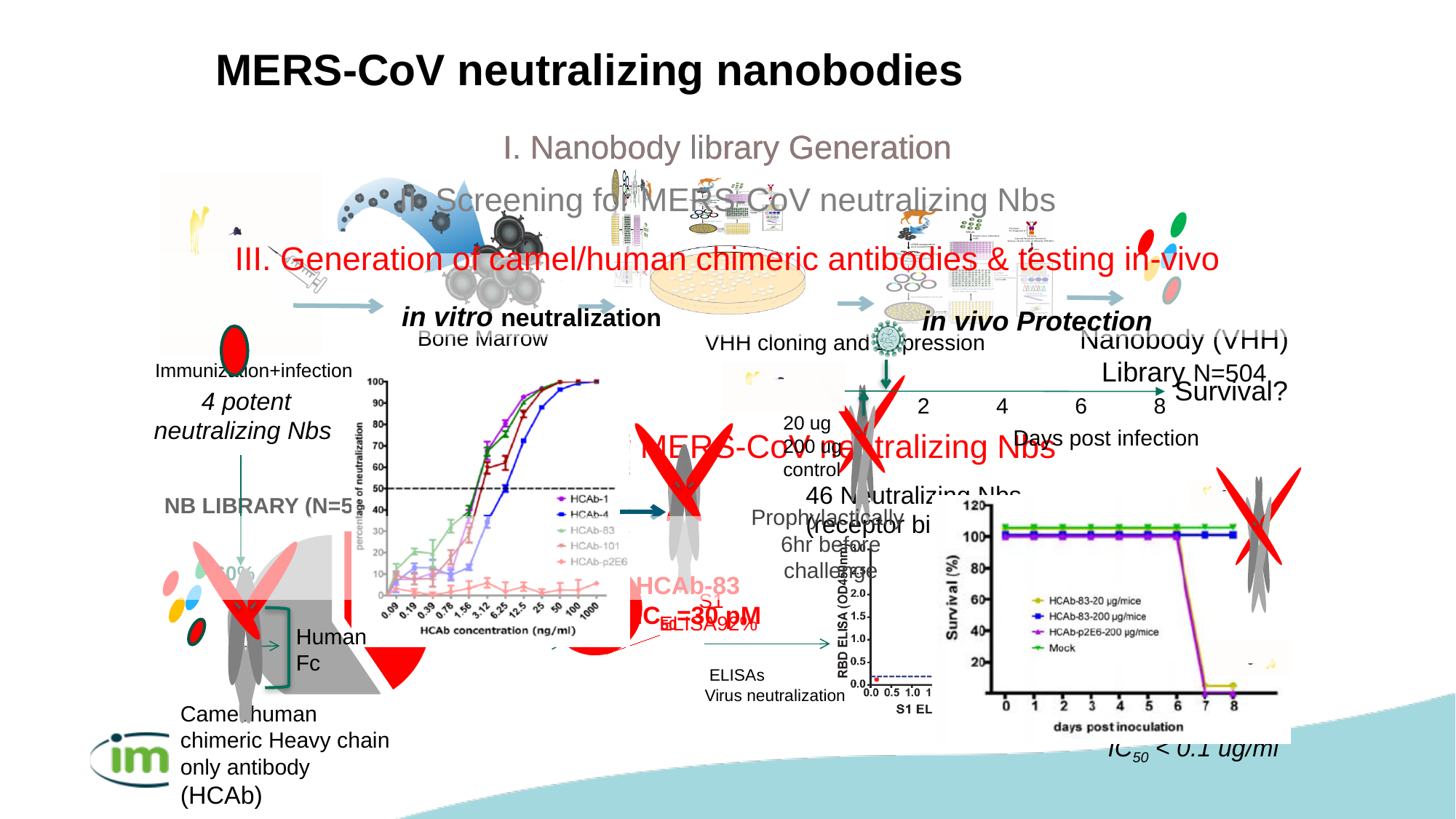
How many series does the legend of the in vitro neutralization chart list? 5 What kind of chart is the in vitro neutralization chart (percentage of neutralization vs HCAb concentration)? line chart In the survival chart, is the value for HCAb-p2E6-200 µg/mice at day 8 greater or less than 20? less In the in vitro neutralization chart, what is the label of the x axis? HCAb concentration (ng/ml) What kind of chart is the survival chart (Survival (%) vs days post inoculation)? line chart How many series does the legend of the survival chart list? 4 In the survival chart, what is the survival percentage for HCAb-83-200 µg/mice at day 8? 100 In the in vitro neutralization chart, does the percentage of neutralization for HCAb-1 rise or fall as HCAb concentration increases? rise In the survival chart, which is larger at day 8: the survival for HCAb-83-200 µg/mice or for HCAb-83-20 µg/mice? HCAb-83-200 µg/mice In the in vitro neutralization chart, which series has the lowest neutralization at 1000 ng/ml? HCAb-p2E6 In the survival chart, how many days post inoculation are marked on the x axis? 9 In the in vitro neutralization chart, is the value for HCAb-p2E6 at 1000 ng/ml greater or less than 50? less